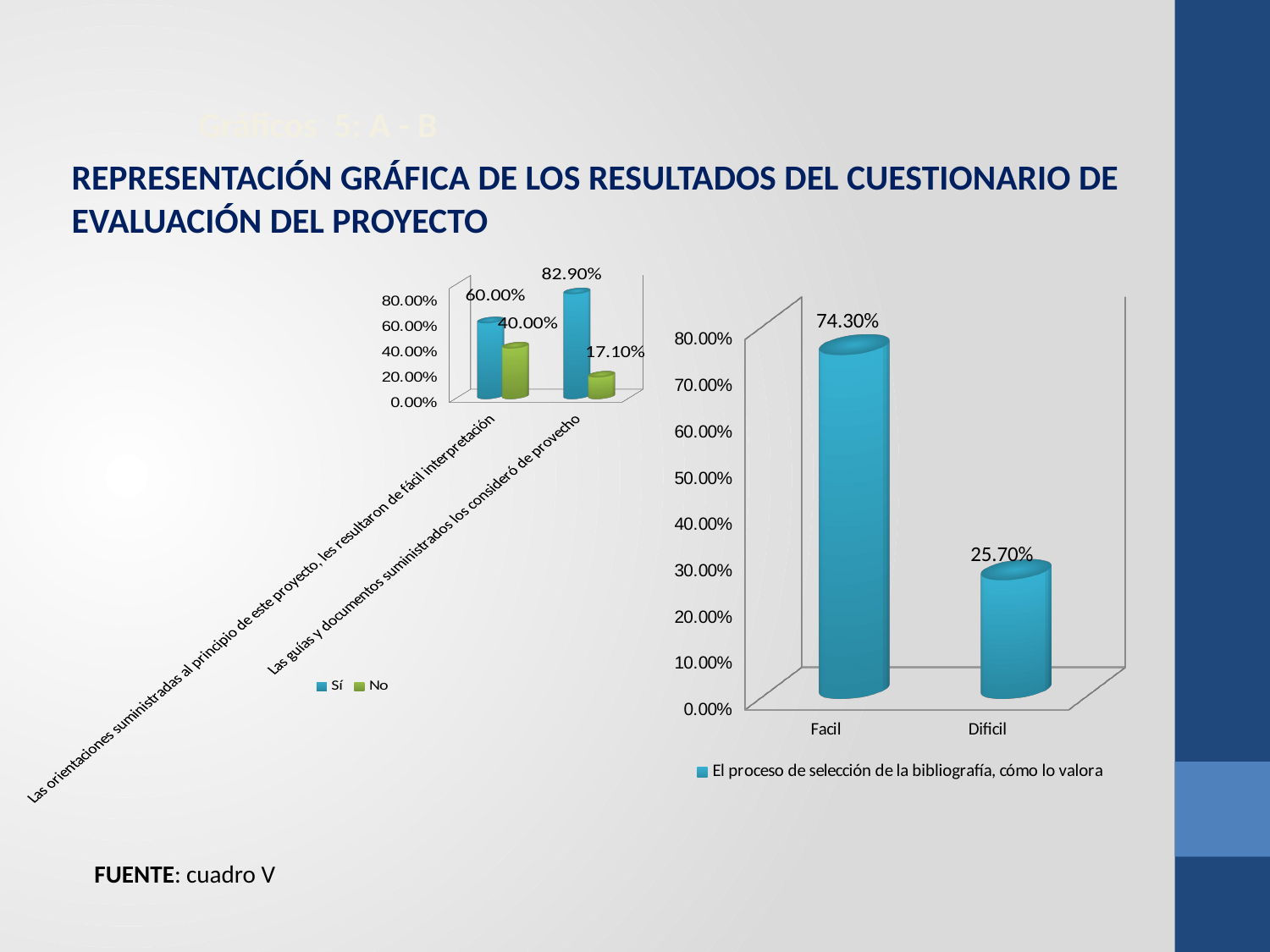
In the chart on the right, which category has the highest value? Facil In the chart on the right, what is the value for Facil? 74.30% What kind of chart is the chart on the right? Bar chart In the chart on the left, how many series does the legend list? 2 In the chart on the right, what is the value for Dificil? 25.70% In the chart on the left, what is the Sí value for 'Las guías y documentos suministrados los consideró de provecho'? 82.90% In the chart on the left, which is larger: the Sí value or the No value for 'Las guías y documentos suministrados los consideró de provecho'? Sí In the chart on the right, how many categories are shown on the x axis? 2 In the chart on the right, what series name does the legend show? El proceso de selección de la bibliografía, cómo lo valora In the chart on the right, what is the difference between the values for Facil and Dificil? 48.60% In the chart on the left, what is the No value for 'Las orientaciones suministradas al principio de este proyecto, les resultaron de fácil interpretación'? 40.00% In the chart on the left, what is the difference between the Sí and No values for 'Las orientaciones suministradas al principio de este proyecto, les resultaron de fácil interpretación'? 20.00%